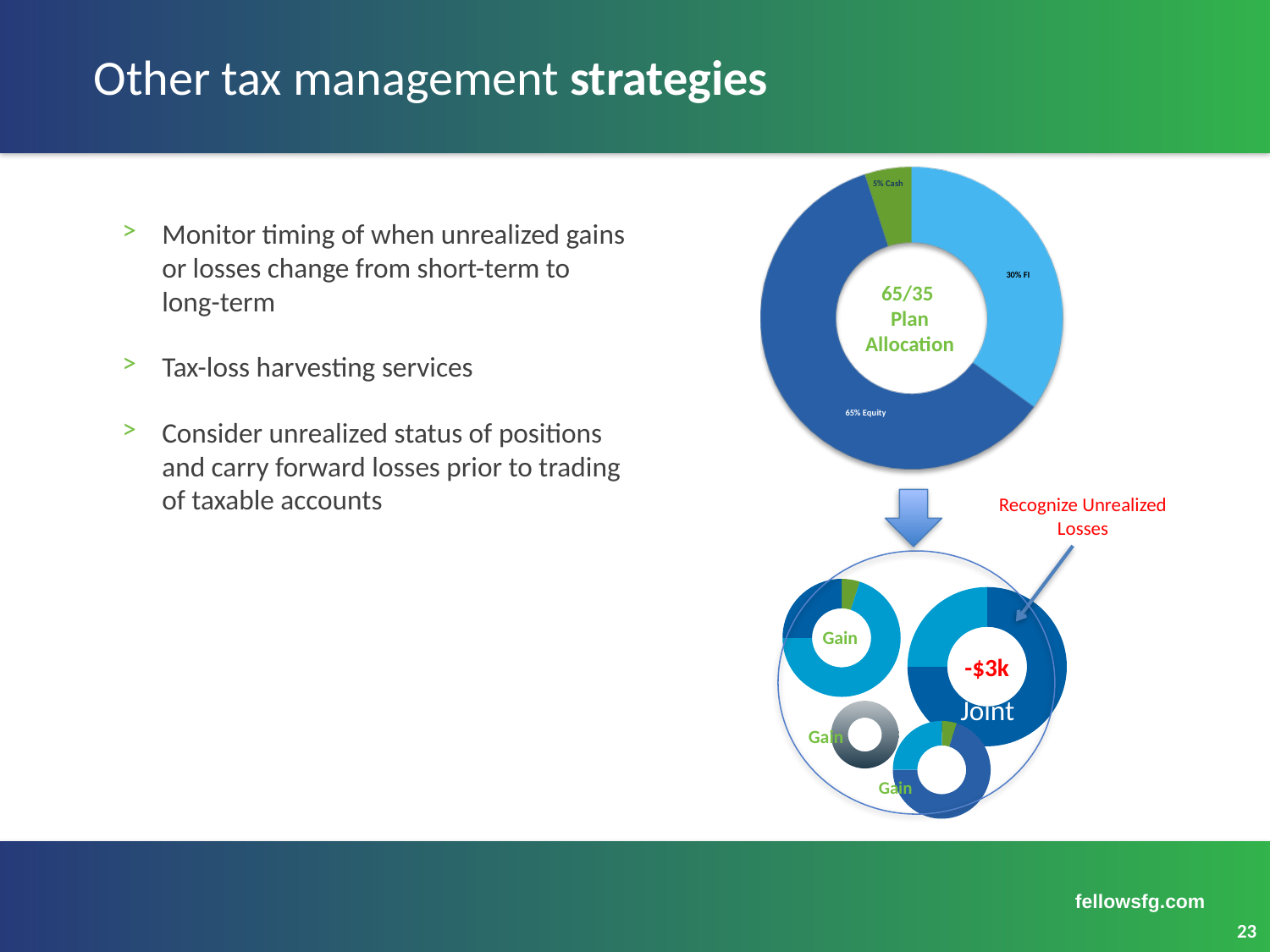
In the 65/35 Plan Allocation chart, which category has the largest share? Equity In the 65/35 Plan Allocation chart, what colour is the Cash slice? Green In the 65/35 Plan Allocation chart, what is the difference between the Equity share and the FI share? 35% What kind of chart is the 65/35 Plan Allocation chart? Donut (pie) chart In the 65/35 Plan Allocation chart, what share is allocated to Cash? 5% What text appears in the center of the large donut chart at the top right? 65/35 Plan Allocation In the smaller donut charts at the bottom right, what value is shown for the Joint account? -$3k In the 65/35 Plan Allocation chart, what share is allocated to FI? 30% In the 65/35 Plan Allocation chart, which category has the smallest share? Cash How many categories are shown in the 65/35 Plan Allocation chart? 3 In the 65/35 Plan Allocation chart, what share is allocated to Equity? 65% In the 65/35 Plan Allocation chart, which is larger, the FI share or the Cash share? FI